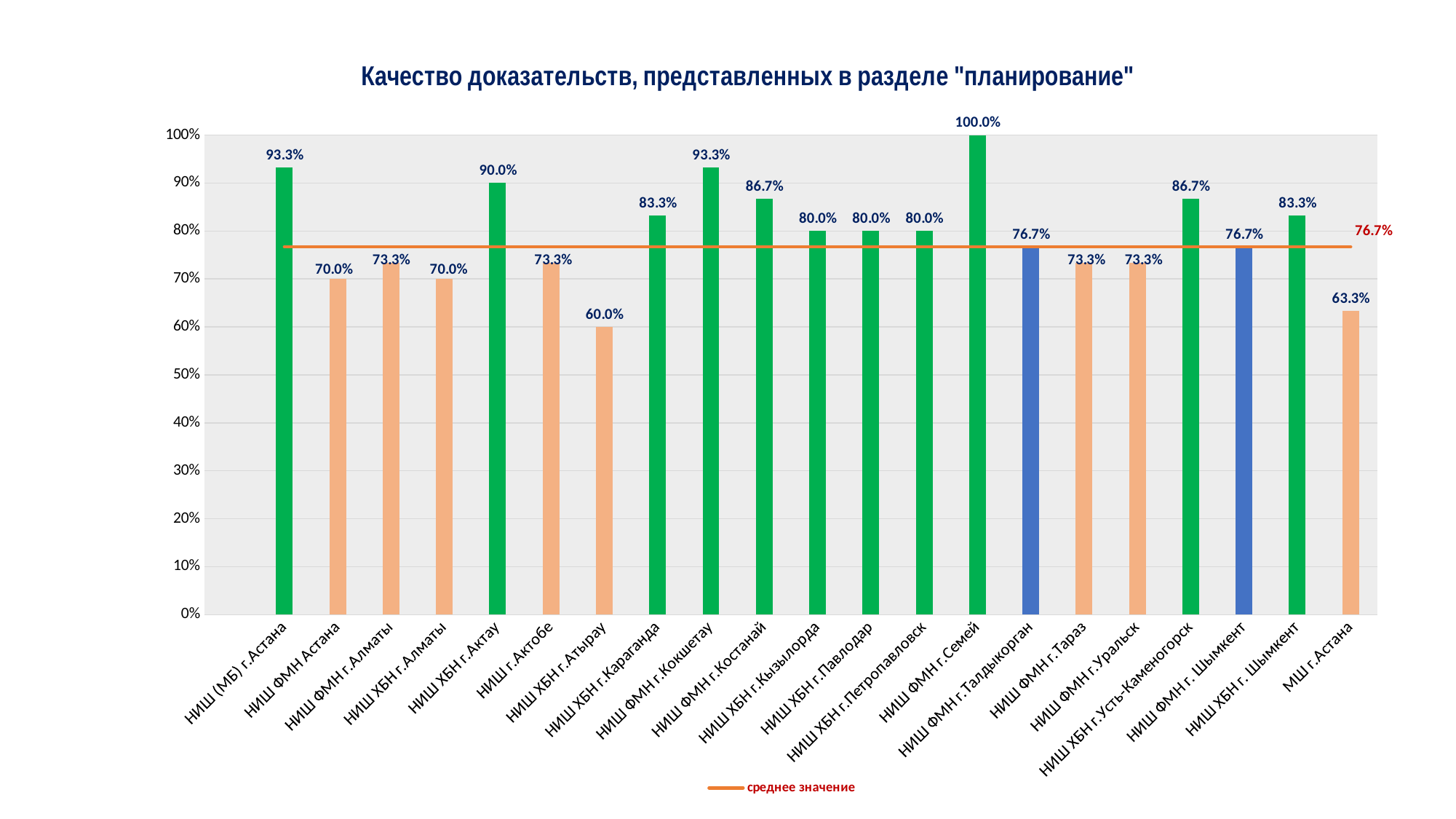
What is the value for НИШ ХБН г.Атырау? 60.0% What is the value for МШ г.Астана? 63.3% Which category has the highest value? НИШ ФМН г.Семей What is the value for НИШ ФМН г.Семей? 100.0% Which is larger, the value for НИШ ХБН г.Актау or the value for НИШ ХБН г.Караганда? НИШ ХБН г.Актау What is the value for НИШ ХБН г.Усть-Каменогорск? 86.7% What value does the horizontal line labelled 'среднее значение' mark? 76.7% Which category has the lowest value? НИШ ХБН г.Атырау What is the difference between the values for НИШ (МБ) г.Астана and НИШ ФМН Астана? 23.3% What type of chart is shown on the slide? bar chart What is the title of the chart? Качество доказательств, представленных в разделе "планирование" How many categories are shown on the x axis? 21